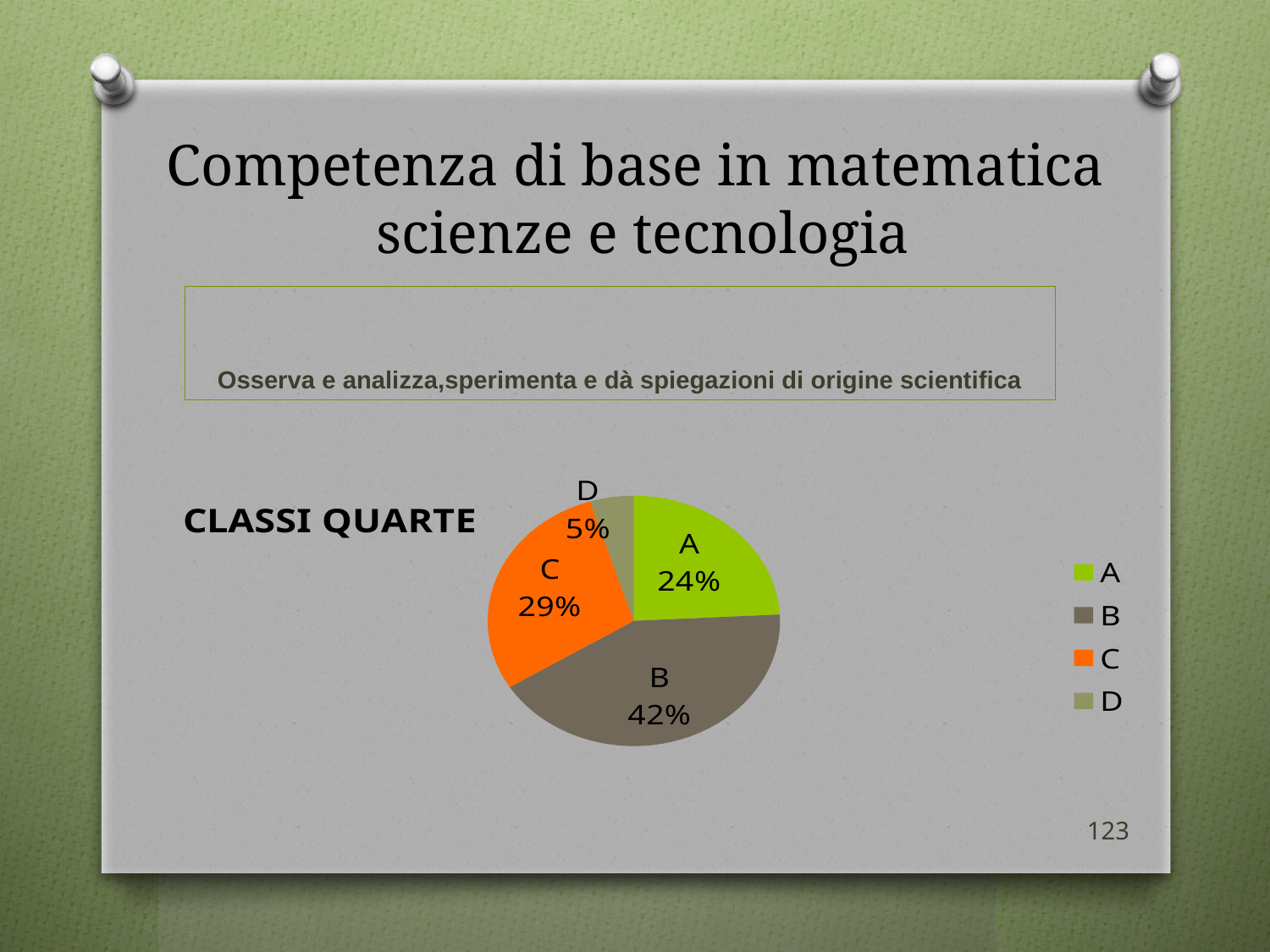
What is the difference in percentage points between slice B and slice A? 18 How many entries does the legend list? 4 What percentage does slice D represent in the pie chart? 5% What percentage does slice B represent in the pie chart? 42% Which slice of the pie chart is the smallest? D What colour is slice C in the pie chart? orange What kind of chart is shown on the slide? pie chart What percentage does slice A represent in the pie chart? 24% What percentage does slice C represent in the pie chart? 29% Which is larger, slice C or slice A? C Which slice of the pie chart is the largest? B How many slices does the pie chart have? 4